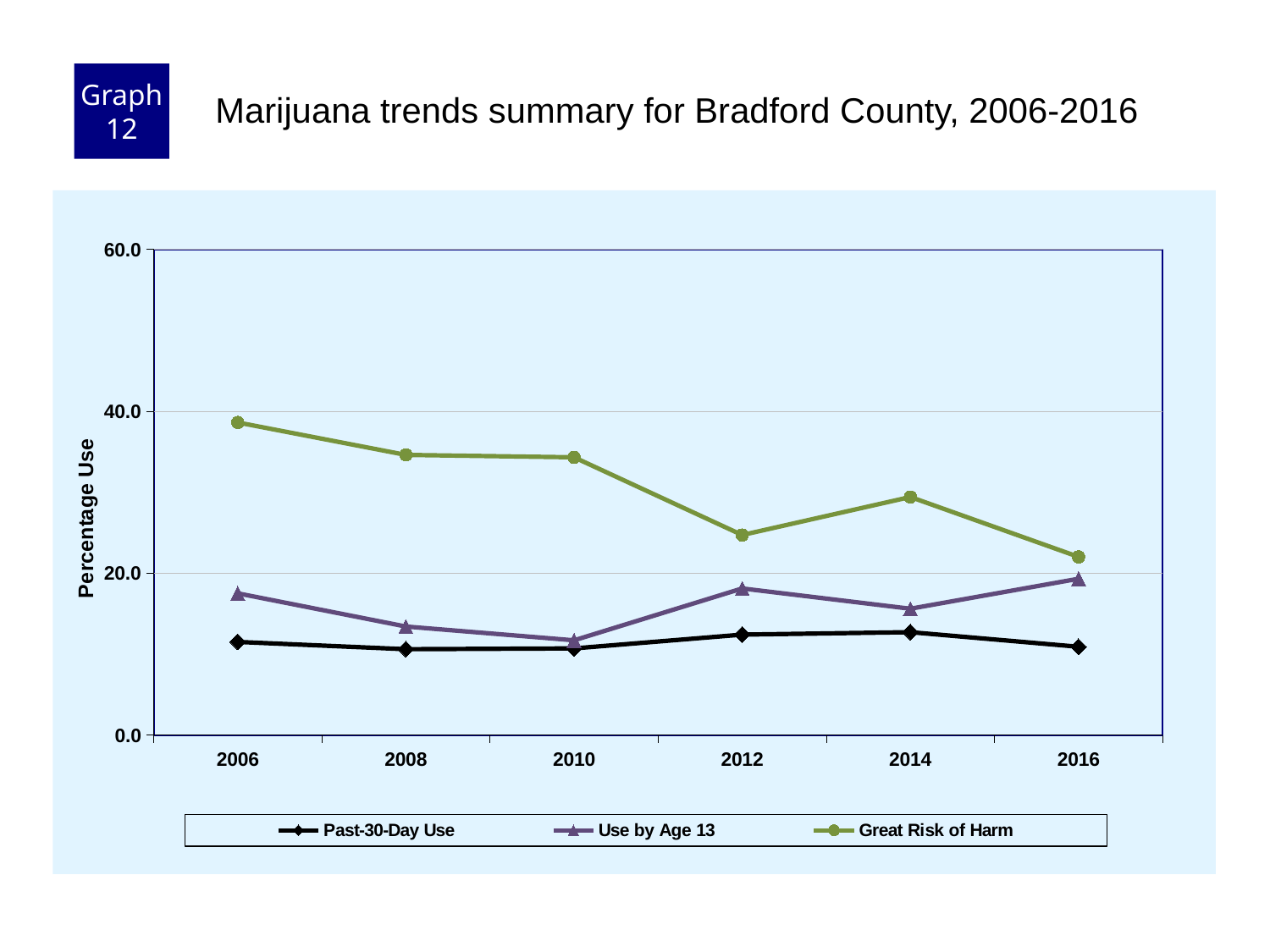
Does the Great Risk of Harm series generally rise or fall from 2006 to 2016? fall Is the value for Use by Age 13 in 2010 greater or less than 20.0? less In which year is the Great Risk of Harm series at its lowest? 2016 In which year is the Great Risk of Harm series at its highest? 2006 What is the label on the y axis? Percentage Use Is the value for Great Risk of Harm in 2006 greater or less than 20.0? greater Which series has the highest value in 2014? Great Risk of Harm How many years are plotted along the x axis? 6 In 2006, which is larger: Great Risk of Harm or Past-30-Day Use? Great Risk of Harm How many series does the legend list? 3 What kind of chart is shown on the slide? line chart Is the value for Great Risk of Harm in 2012 greater or less than 40.0? less